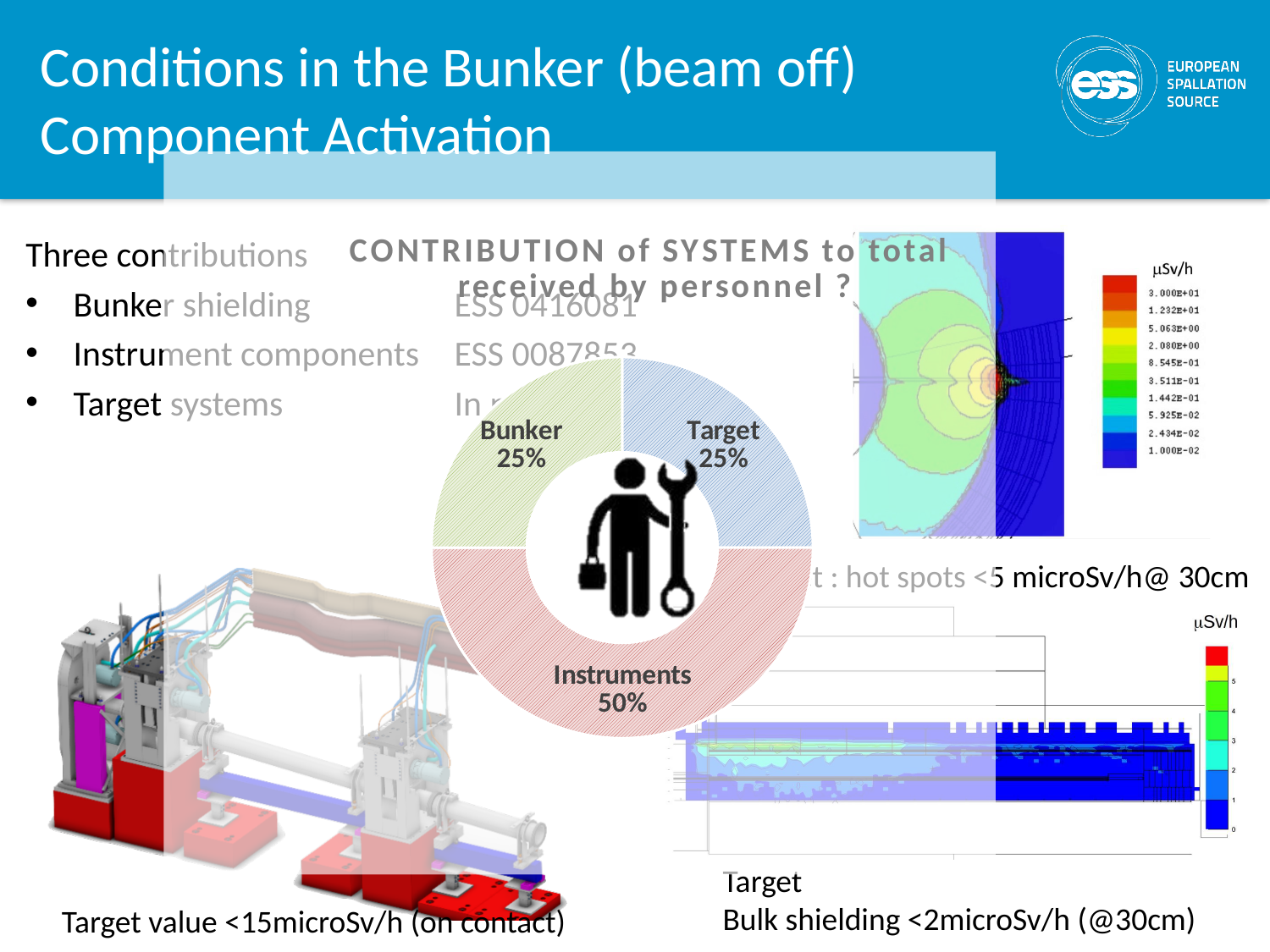
What is the difference between the Instruments share and the Bunker share in the pie chart? 25% What share of the total received by personnel is attributed to Target in the pie chart? 25% How many slices does the pie chart have? 3 Is the Instruments share in the pie chart greater or less than 40%? greater Which system contributes the largest share in the pie chart? Instruments What share of the total received by personnel is attributed to Instruments in the pie chart? 50% What are the three systems named in the pie chart? Bunker, Target, Instruments What share of the total received by personnel is attributed to Bunker in the pie chart? 25% Which colour is used for the Instruments slice in the pie chart? Red (pink) What kind of chart is used to show the contribution of systems to the total received by personnel? Pie (doughnut) chart What is the combined share of Bunker and Target in the pie chart? 50% Which is larger in the pie chart, the Instruments share or the Target share? Instruments